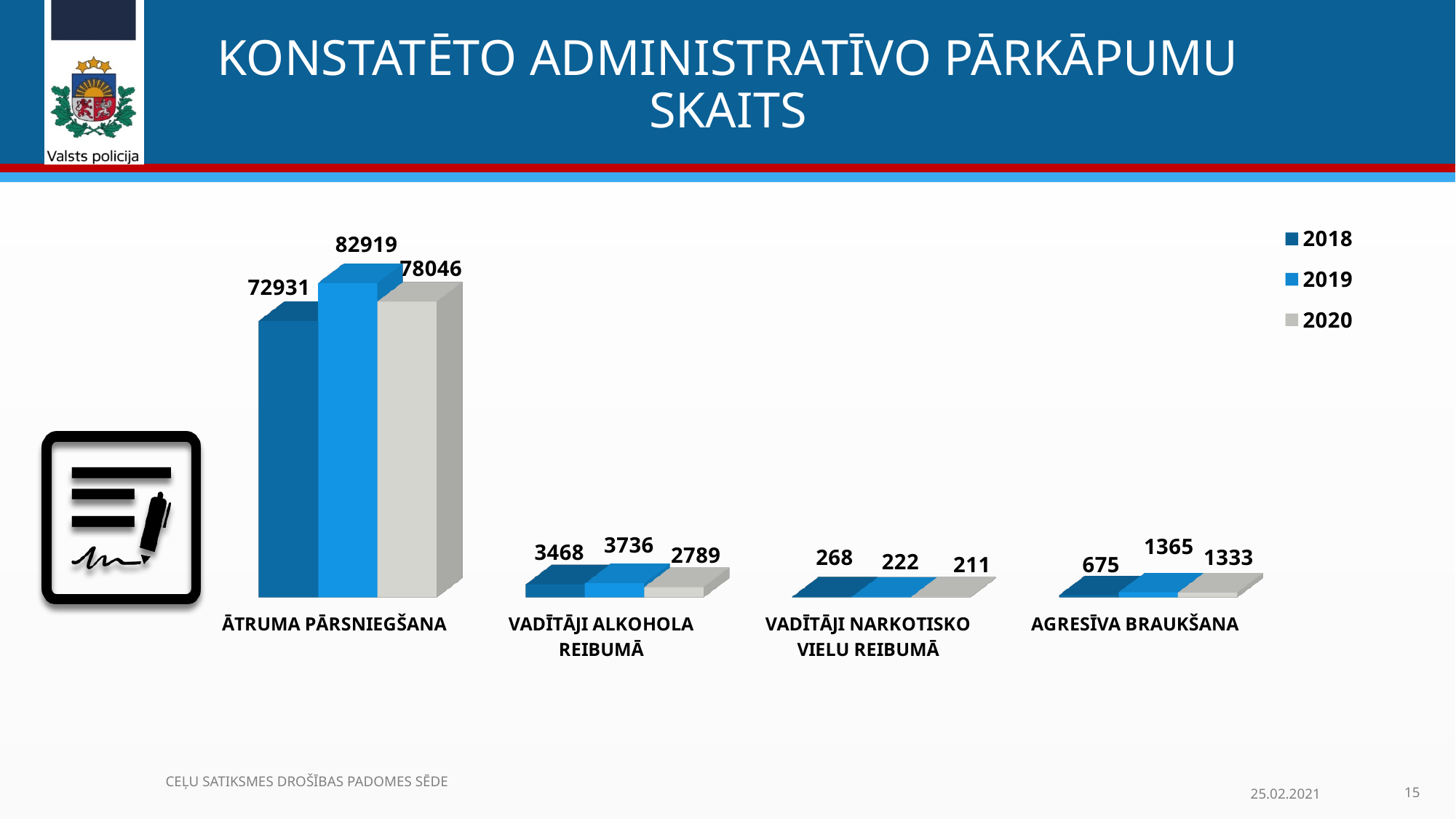
What is the difference between the 2019 and 2018 values for ĀTRUMA PĀRSNIEGŠANA? 9988 What kind of chart is shown on the slide? Bar chart How many categories are shown on the x axis? 4 Which is larger for VADĪTĀJI ALKOHOLA REIBUMĀ: the 2018 value or the 2020 value? 2018 What is the value for ĀTRUMA PĀRSNIEGŠANA in 2019? 82919 What is the value for VADĪTĀJI NARKOTISKO VIELU REIBUMĀ in 2019? 222 Which category has the highest value in 2020? ĀTRUMA PĀRSNIEGŠANA What is the value for VADĪTĀJI ALKOHOLA REIBUMĀ in 2020? 2789 How many series does the legend list? 3 What is the value for AGRESĪVA BRAUKŠANA in 2018? 675 Which category has the lowest value in 2018? VADĪTĀJI NARKOTISKO VIELU REIBUMĀ What is the difference between the 2019 and 2020 values for AGRESĪVA BRAUKŠANA? 32